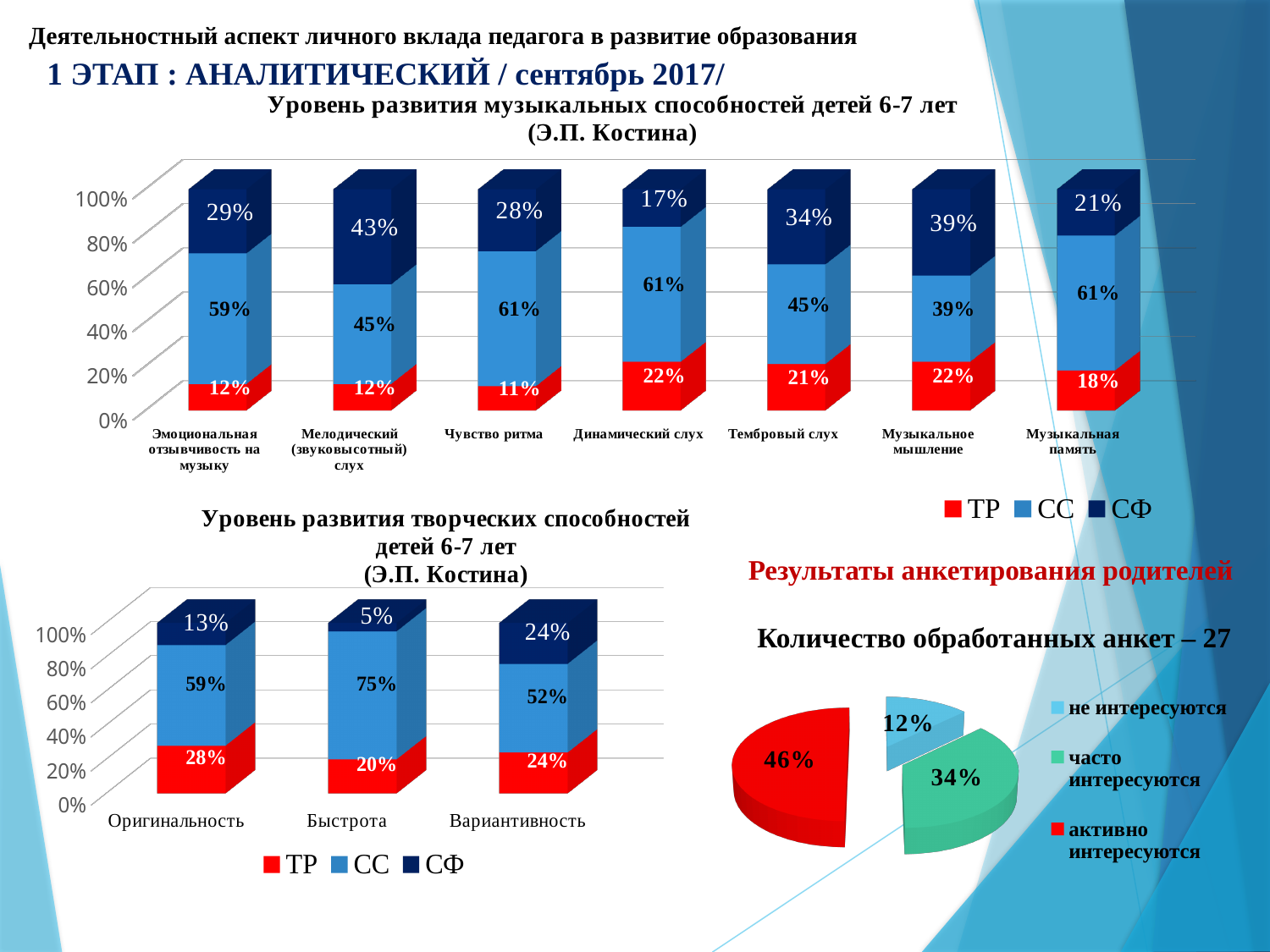
In the top chart 'Уровень развития музыкальных способностей детей 6-7 лет', how much larger is the СС value for 'Чувство ритма' than the СС value for 'Мелодический (звуковысотный) слух'? 16% In the bottom-left chart 'Уровень развития творческих способностей детей 6-7 лет', which has the larger СФ value: 'Оригинальность' or 'Вариантивность'? Вариантивность In the bottom-left chart 'Уровень развития творческих способностей детей 6-7 лет', what is the СС value for 'Быстрота'? 75% How many categories are shown in the top chart 'Уровень развития музыкальных способностей детей 6-7 лет'? 7 In the pie chart 'Результаты анкетирования родителей', which slice is the smallest? не интересуются In the top chart 'Уровень развития музыкальных способностей детей 6-7 лет', what is the ТР value for 'Динамический слух'? 22% In the top chart 'Уровень развития музыкальных способностей детей 6-7 лет', which category has the lowest ТР value? Чувство ритма How many series does the legend of the top chart 'Уровень развития музыкальных способностей детей 6-7 лет' list? 3 In the top chart 'Уровень развития музыкальных способностей детей 6-7 лет', which category has the highest СФ value? Мелодический (звуковысотный) слух In the pie chart 'Результаты анкетирования родителей', what share of the pie is 'активно интересуются'? 46% In the top chart 'Уровень развития музыкальных способностей детей 6-7 лет', what is the СФ value for 'Мелодический (звуковысотный) слух'? 43% What kind of chart is the bottom-left chart 'Уровень развития творческих способностей детей 6-7 лет'? Stacked bar chart